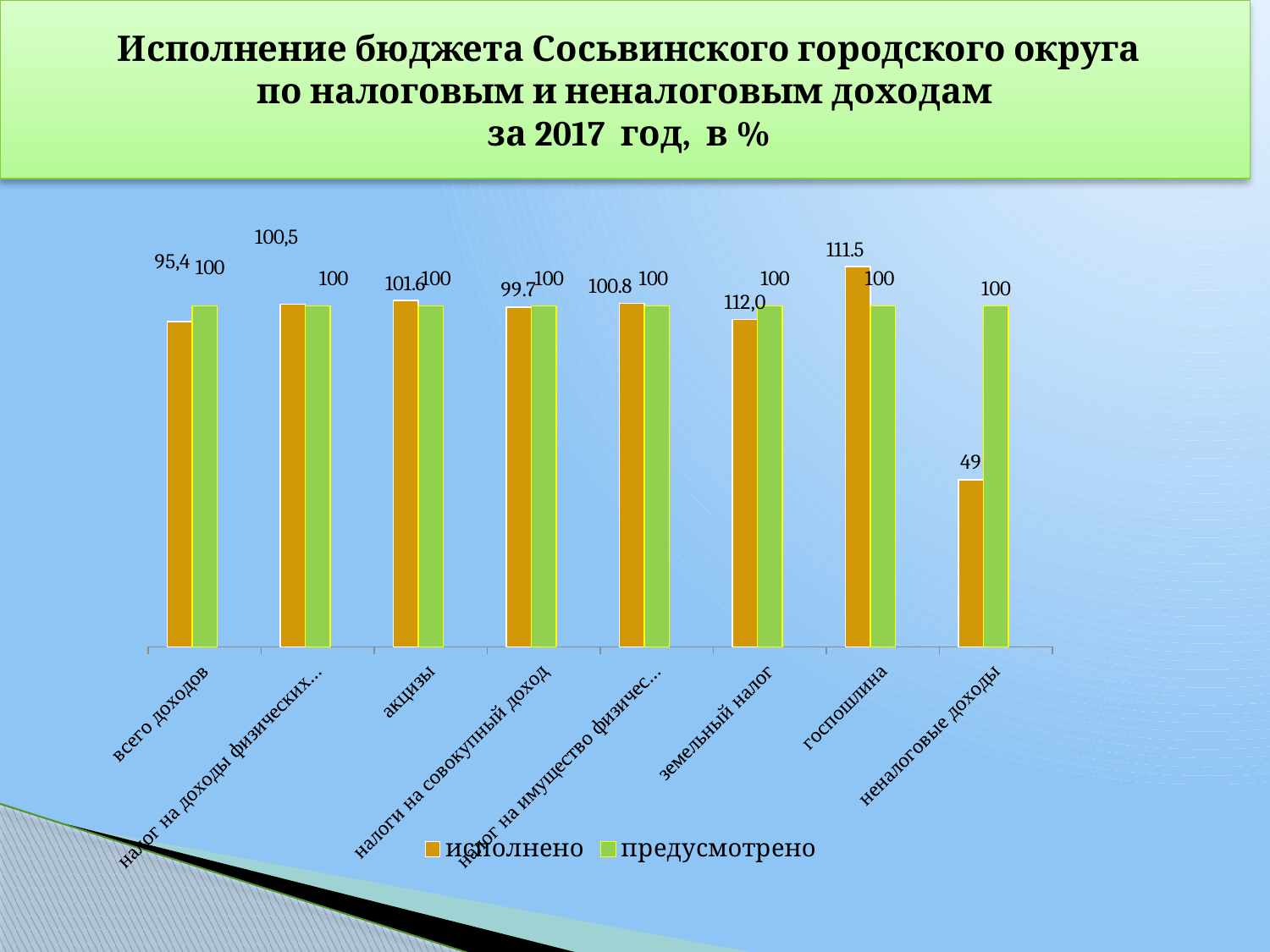
What kind of chart is shown on the slide? bar chart For всего доходов, which is larger: исполнено or предусмотрено? предусмотрено How many categories are shown on the x axis? 8 What is the предусмотрено value for земельный налог? 100 What is the исполнено value for акцизы? 101.6 What is the исполнено value for неналоговые доходы? 49 What is the исполнено value for всего доходов? 95,4 What is the исполнено value for налоги на совокупный доход? 99.7 What is the difference between the предусмотрено and исполнено values for неналоговые доходы? 51 Which category has the lowest исполнено value? неналоговые доходы How many series does the legend list? 2 What is the исполнено value for госпошлина? 111.5